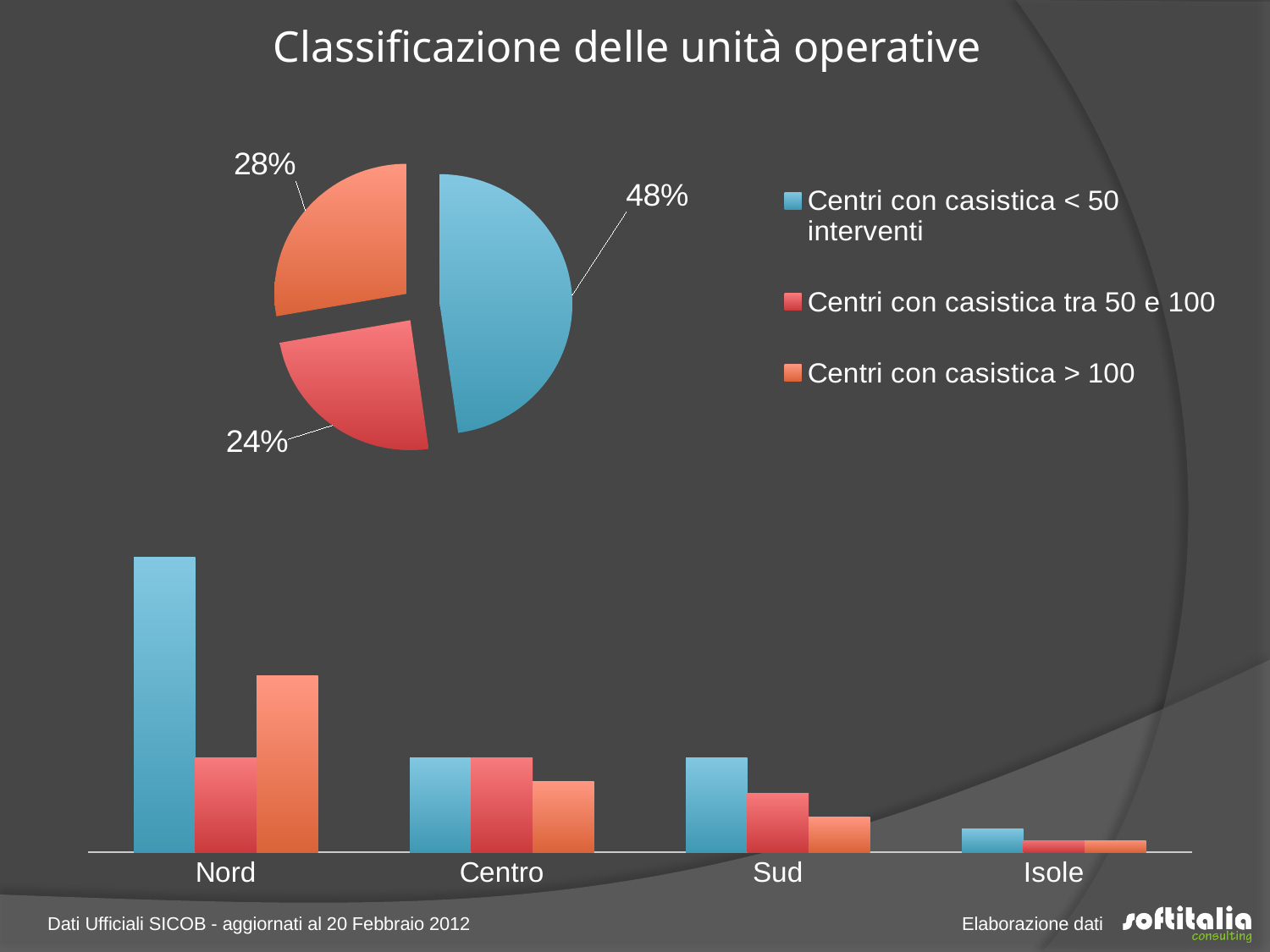
In the bar chart at the bottom, for Nord, which is larger: the bar for Centri con casistica tra 50 e 100 or the bar for Centri con casistica > 100? Centri con casistica > 100 In the pie chart, what share is shown for Centri con casistica > 100? 28% How many categories does the bar chart at the bottom of the slide show? 4 In the pie chart, what share is shown for Centri con casistica tra 50 e 100? 24% In the pie chart, what share is shown for Centri con casistica < 50 interventi? 48% In the pie chart, which category has the largest slice? Centri con casistica < 50 interventi How many entries does the legend list? 3 In the bar chart at the bottom, which region has the tallest bar for Centri con casistica < 50 interventi? Nord In the pie chart, which category has the smallest slice? Centri con casistica tra 50 e 100 In the pie chart, what is the difference in percentage points between the slice for Centri con casistica < 50 interventi and the slice for Centri con casistica > 100? 20 What kind of chart is the chart at the bottom of the slide? bar chart In the bar chart at the bottom, which region has the lowest bars overall? Isole